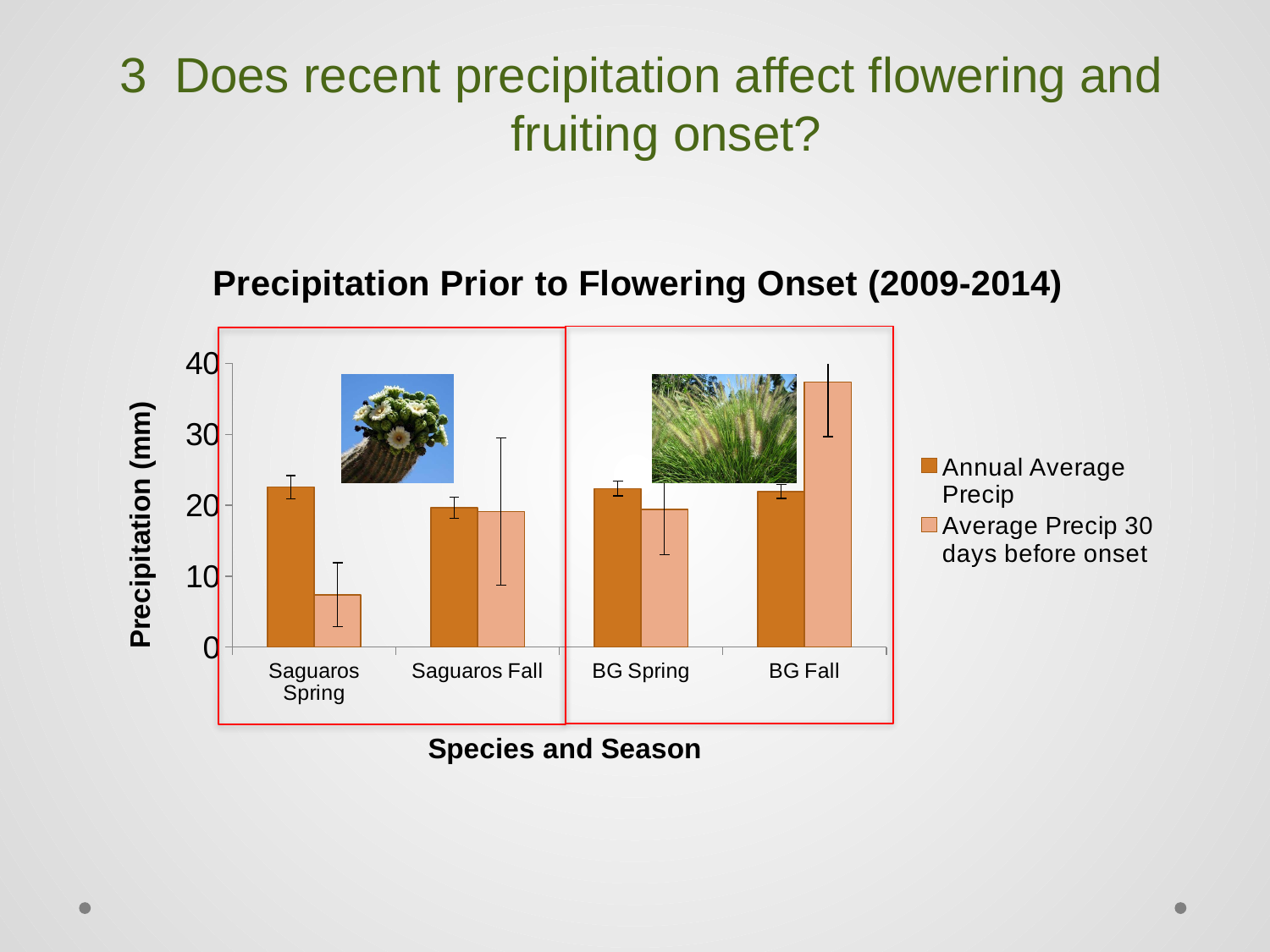
What is the title of the chart? Precipitation Prior to Flowering Onset (2009-2014) Which category has the highest Average Precip 30 days before onset? BG Fall Which category has the lowest Average Precip 30 days before onset? Saguaros Spring How many series does the legend list? 2 What kind of chart is shown on the slide? bar chart Is the Average Precip 30 days before onset value for Saguaros Spring greater or less than 10? less What is the label of the y axis? Precipitation (mm) For BG Fall, which is larger: Annual Average Precip or Average Precip 30 days before onset? Average Precip 30 days before onset Is the Average Precip 30 days before onset value for BG Fall greater or less than 30? greater How many categories are shown on the x axis? 4 Is the Annual Average Precip value for Saguaros Spring greater or less than 20? greater